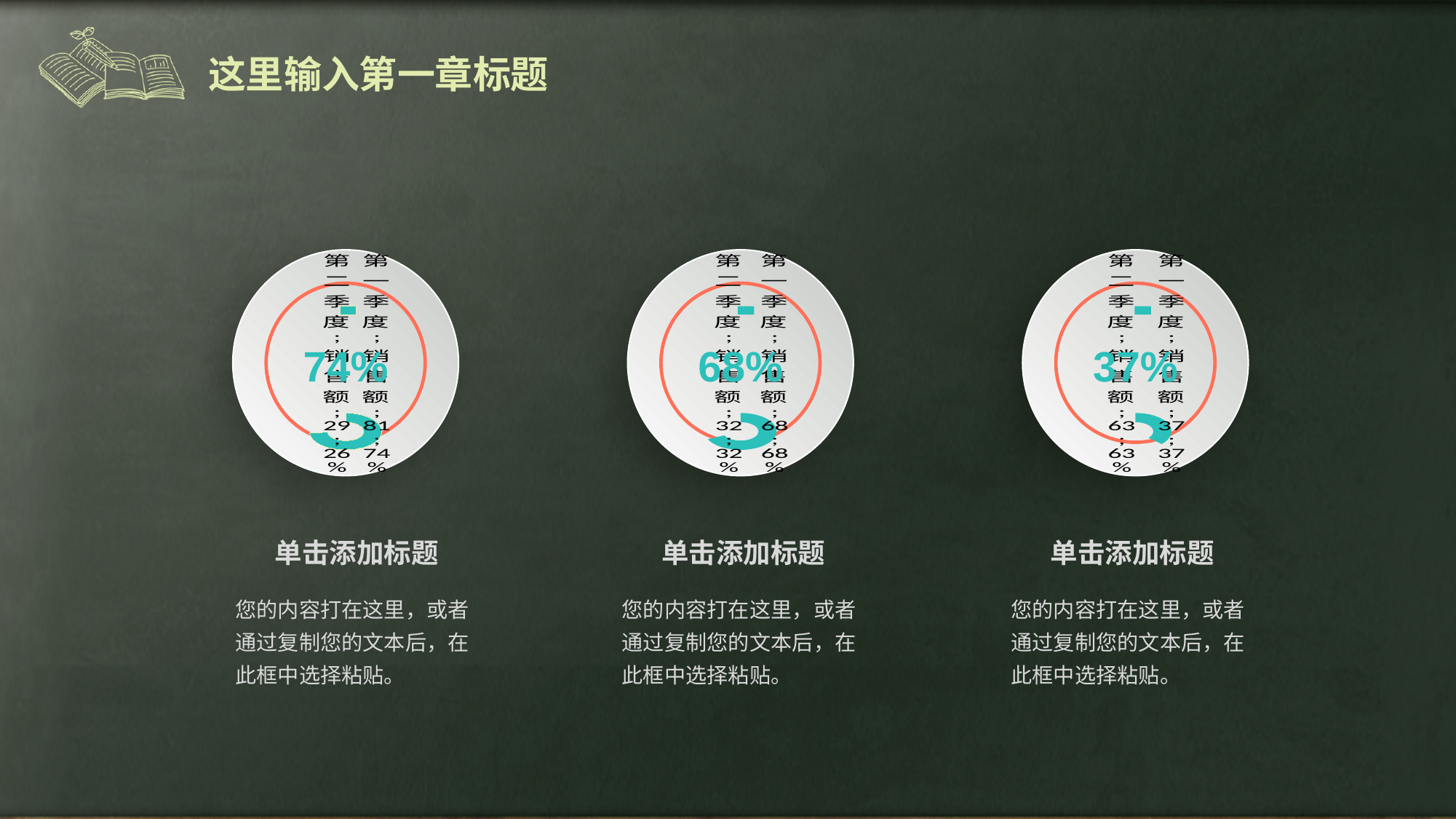
On the right chart, what percentage is displayed in the centre? 37% Which of the three charts shows the highest central percentage? The left chart (74%) On the right chart, which quarter has the larger 销售额 value, 第一季度 or 第二季度? 第二季度 On the middle chart, what percentage is displayed in the centre? 68% Which of the three charts shows the lowest central percentage? The right chart (37%) On the left chart, what is the 销售额 value labelled for 第一季度? 81 How many charts are shown on the slide? 3 On the left chart, what is the 销售额 value labelled for 第二季度? 29 On the left chart, what percentage is displayed in the centre? 74% On the right chart, what is the 销售额 value labelled for 第二季度? 63 What is the difference between the central percentages of the left chart and the middle chart? 6 percentage points On the middle chart, what is the 销售额 value labelled for 第二季度? 32